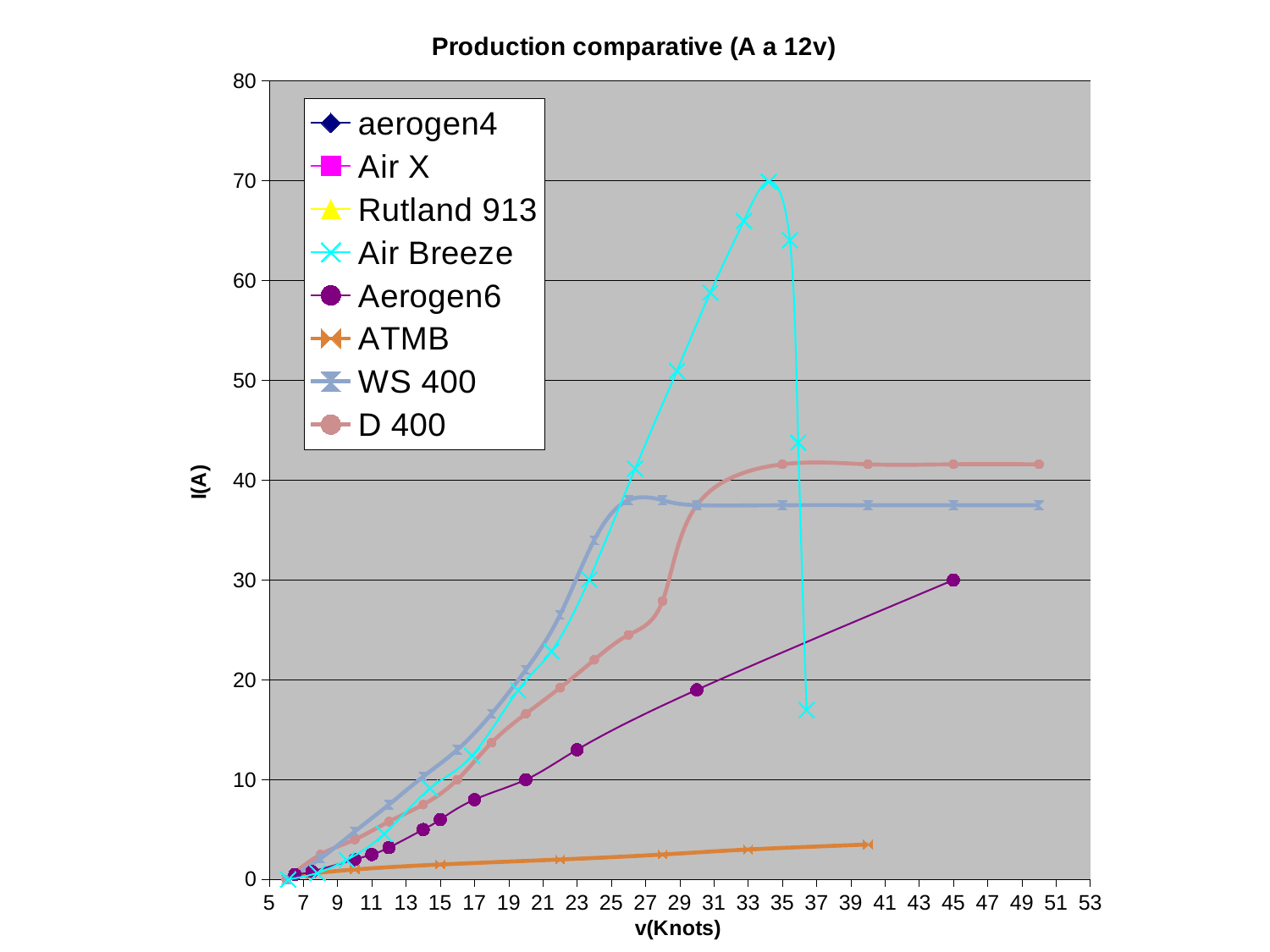
How many series does the legend list? 8 Do the values for ATMB rise or fall as wind speed increases along the x axis? rise Which plotted series has the lowest values across the chart? ATMB Is the value for ATMB at 40 knots greater or less than 10? less Is the value for D 400 at 50 knots greater or less than 40? greater Which series reaches the highest value on the chart? Air Breeze At 50 knots, which series has the higher value, D 400 or WS 400? D 400 What is the label of the x axis? v(Knots) What is the title of the chart? Production comparative (A a 12v) Is the value for Air Breeze at 34 knots greater or less than 60? greater What kind of chart is shown on the slide? line chart